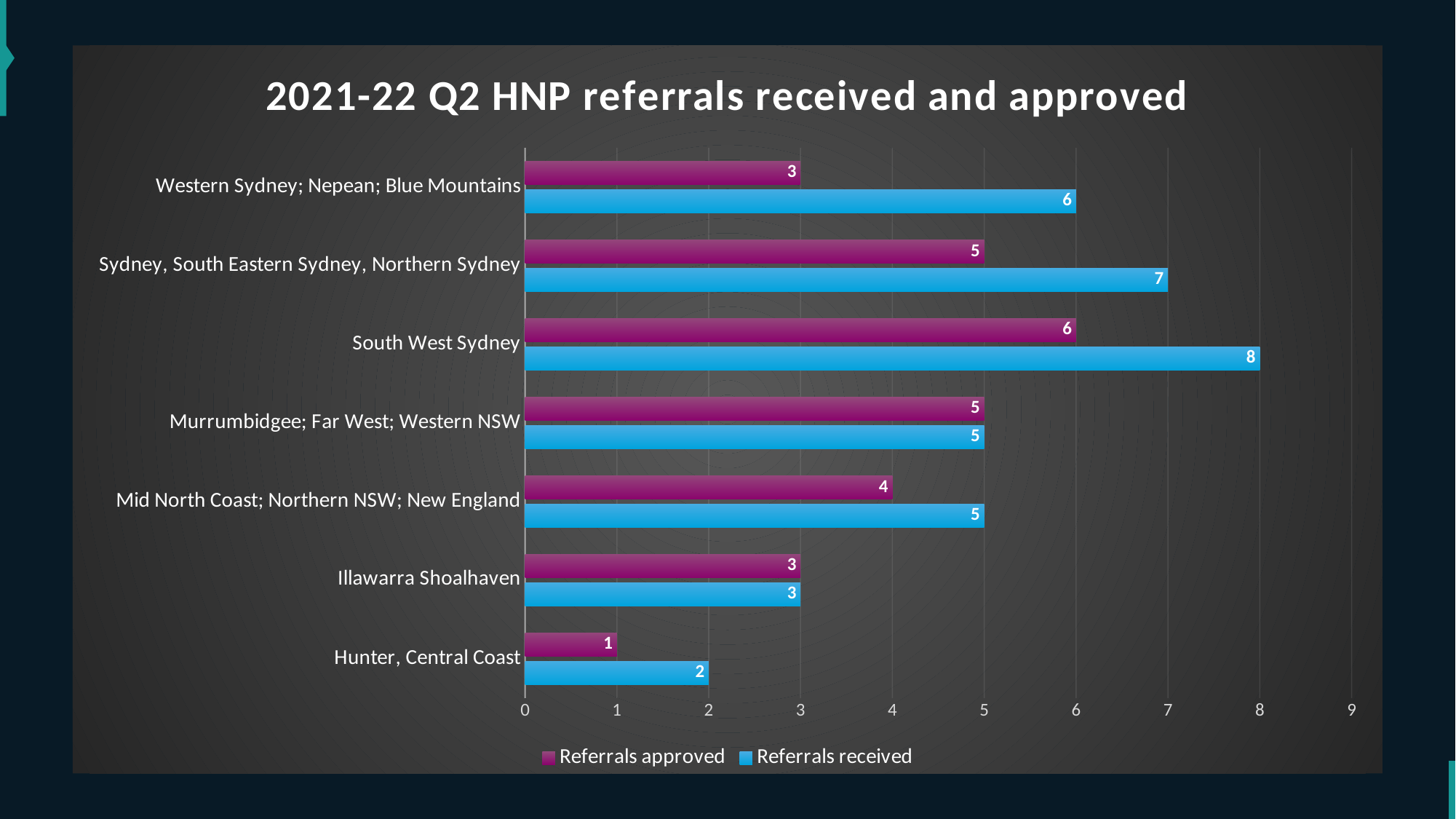
What is the title of the chart? 2021-22 Q2 HNP referrals received and approved How many series does the legend list? 2 Which region had the lowest number of referrals approved? Hunter, Central Coast Which region had the highest number of referrals received? South West Sydney How many referrals were approved for Hunter, Central Coast? 1 Which colour represents referrals received in the chart? Blue How many referrals were received for South West Sydney? 8 How many referrals were approved for Mid North Coast; Northern NSW; New England? 4 What is the difference between referrals received and referrals approved for Western Sydney; Nepean; Blue Mountains? 3 What type of chart is shown on the slide? Bar chart How many regions are shown on the chart? 7 Which is larger for Sydney, South Eastern Sydney, Northern Sydney: referrals received or referrals approved? Referrals received